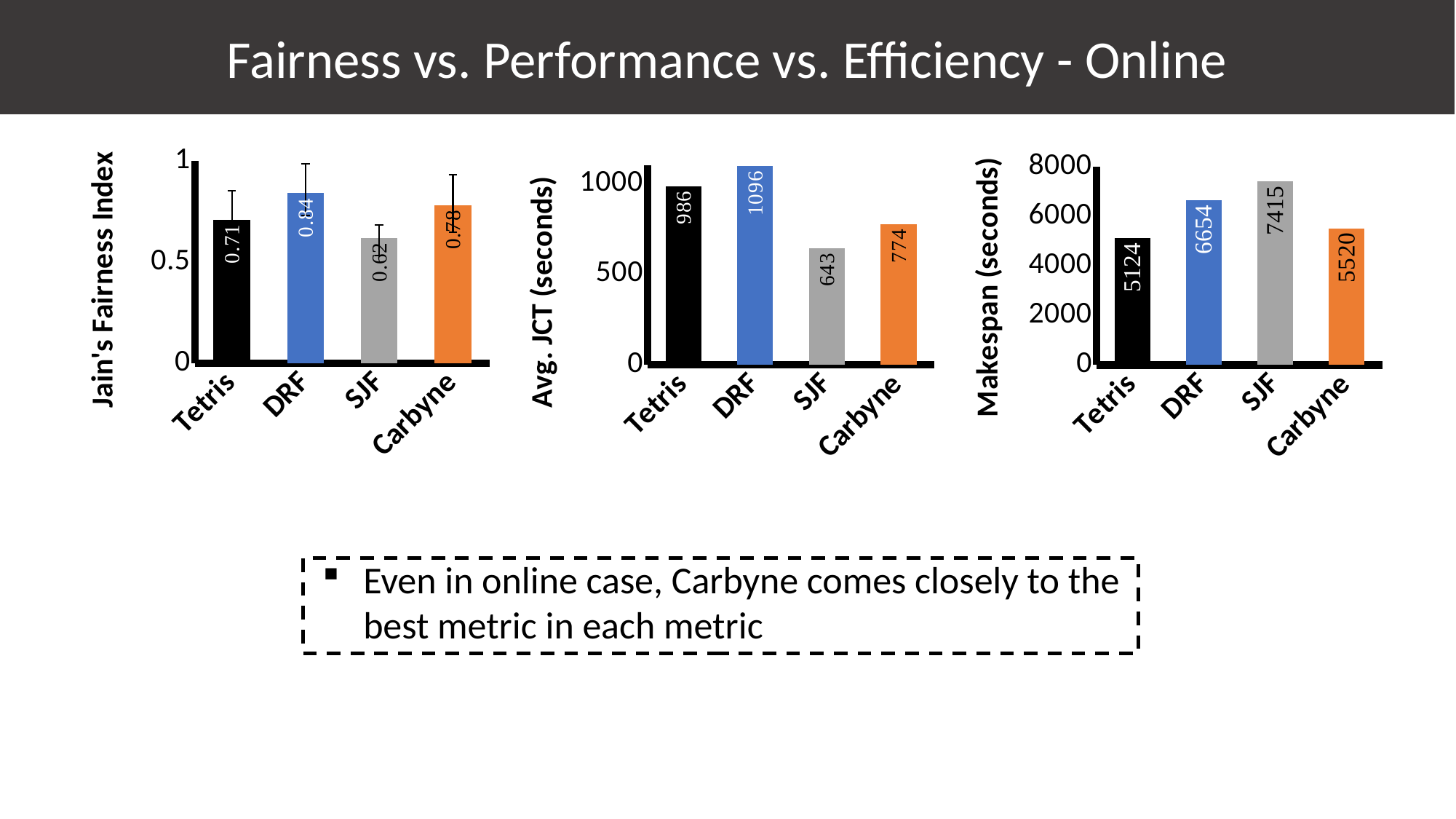
In the right chart (Makespan), what is the difference between Carbyne and Tetris? 396 In the right chart (Makespan), what is the value for SJF? 7415 In the middle chart (Avg. JCT), what is the difference between DRF and SJF? 453 What kind of chart is the middle chart (Avg. JCT)? bar chart In the middle chart (Avg. JCT), which scheduler has the highest value? DRF In the middle chart (Avg. JCT), what is the value for Carbyne? 774 In the left chart (Jain's Fairness Index), which scheduler has the lowest value? SJF In the right chart (Makespan), which is larger, the value for DRF or the value for Carbyne? DRF In the right chart (Makespan), which scheduler has the lowest value? Tetris In the left chart (Jain's Fairness Index), what is the value for DRF? 0.84 How many schedulers are shown in the left chart (Jain's Fairness Index)? 4 What is the y-axis label of the right chart? Makespan (seconds)